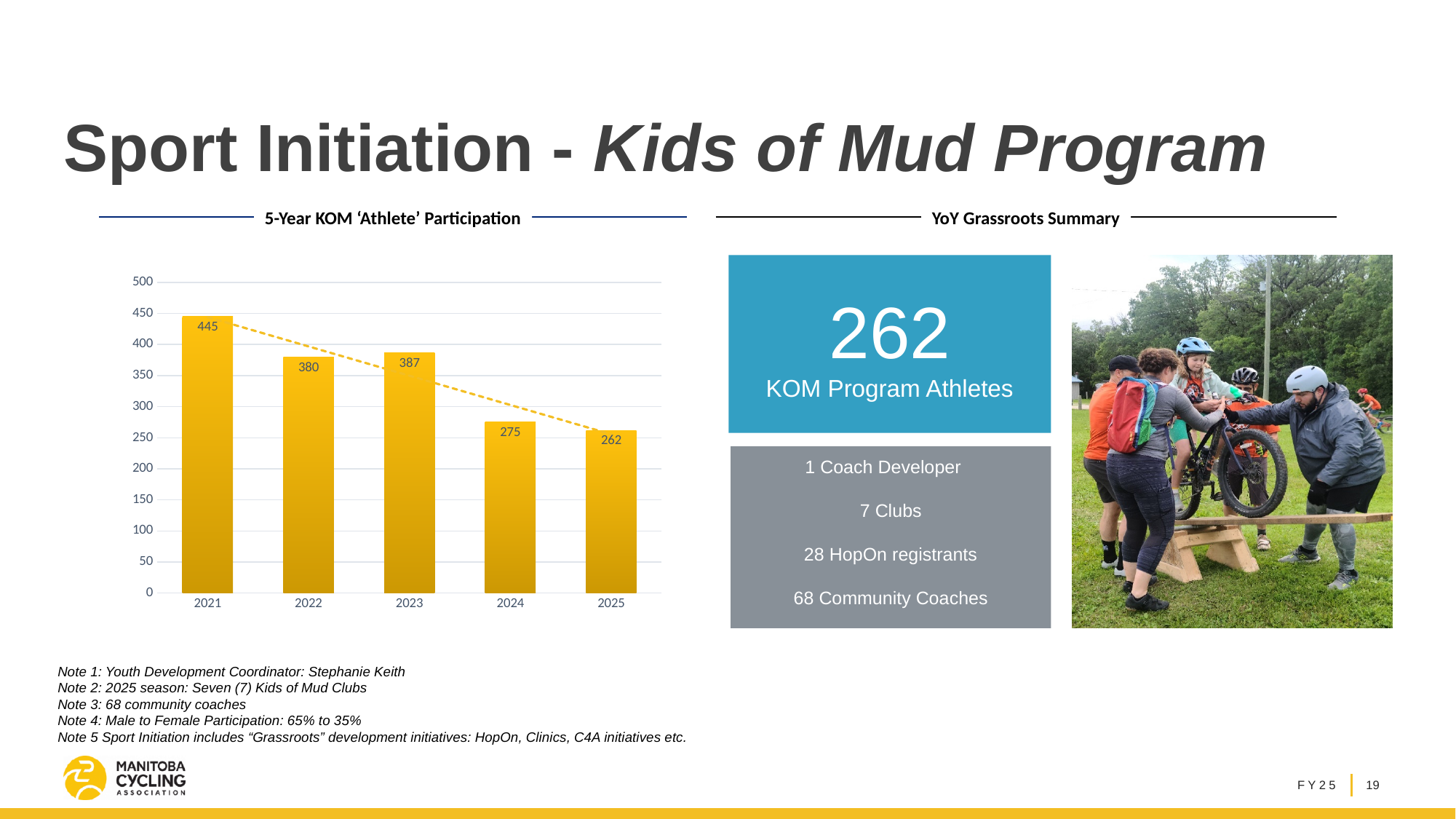
What was the KOM athlete participation in 2025? 262 What is the overall trend in KOM athlete participation from 2021 to 2025? Falling How many years are shown on the chart? 5 Is the value for 2024 greater or less than 300? less What was the KOM athlete participation in 2023? 387 Which year had the highest KOM athlete participation? 2021 What was the KOM athlete participation in 2021? 445 Which year had the lowest KOM athlete participation? 2025 Which year had higher participation, 2022 or 2024? 2022 What is the difference in participation between 2022 and 2023? 7 What kind of chart is used to show the 5-Year KOM 'Athlete' Participation? Bar chart What is the difference in participation between 2021 and 2025? 183